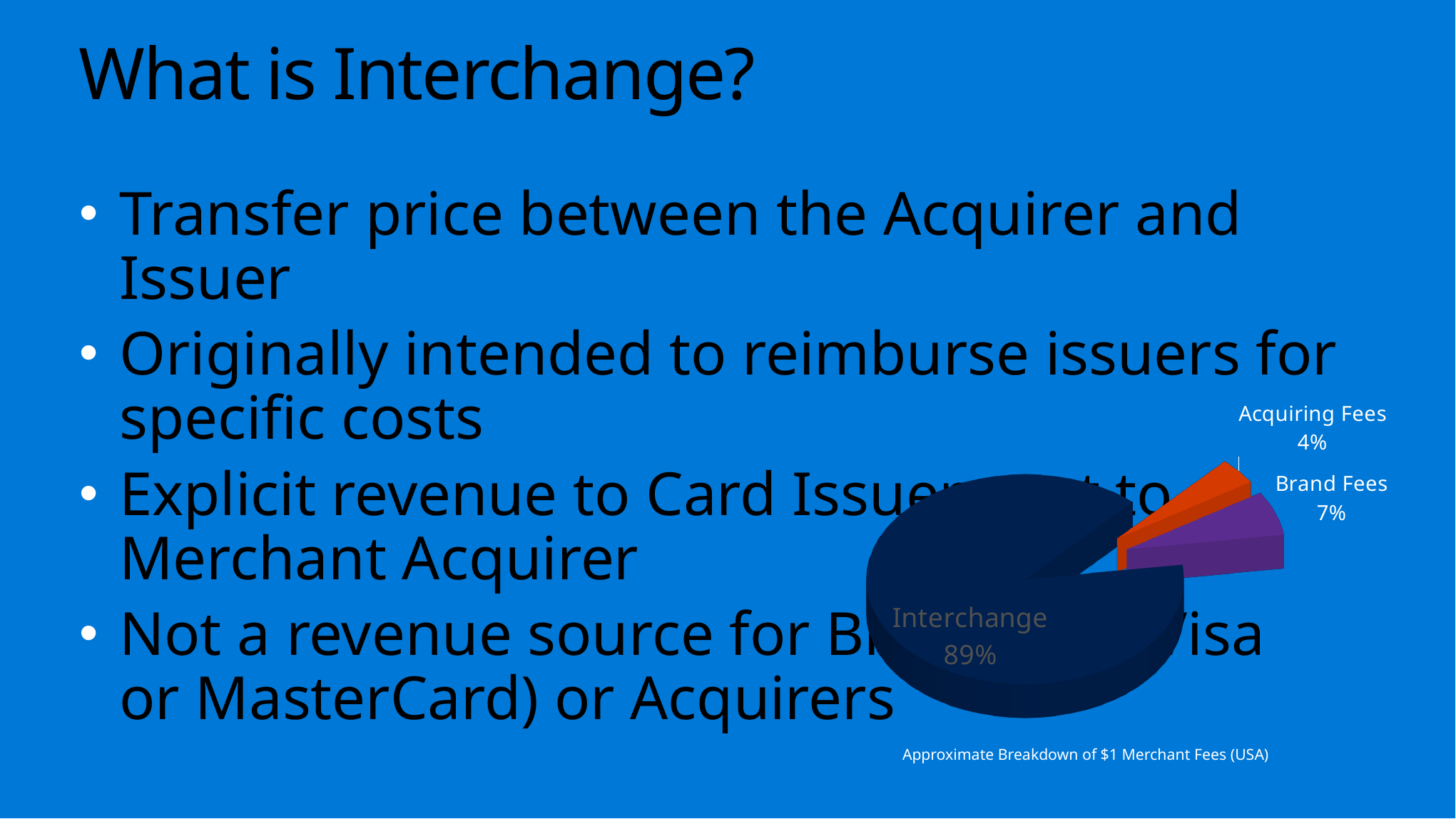
What is the title of the chart? Approximate Breakdown of $1 Merchant Fees (USA) What is the difference in percentage points between Brand Fees and Acquiring Fees? 3 What colour is the Acquiring Fees slice? Orange Which is larger, Brand Fees or Acquiring Fees? Brand Fees What share of the pie does Acquiring Fees represent? 4% How many slices does the pie chart have? 3 Which slice of the pie is the smallest? Acquiring Fees Which slice of the pie is the largest? Interchange What kind of chart is shown on the slide? Pie chart What is the difference in percentage points between Interchange and Brand Fees? 82 What share of the pie does Brand Fees represent? 7% What share of the pie does Interchange represent? 89%